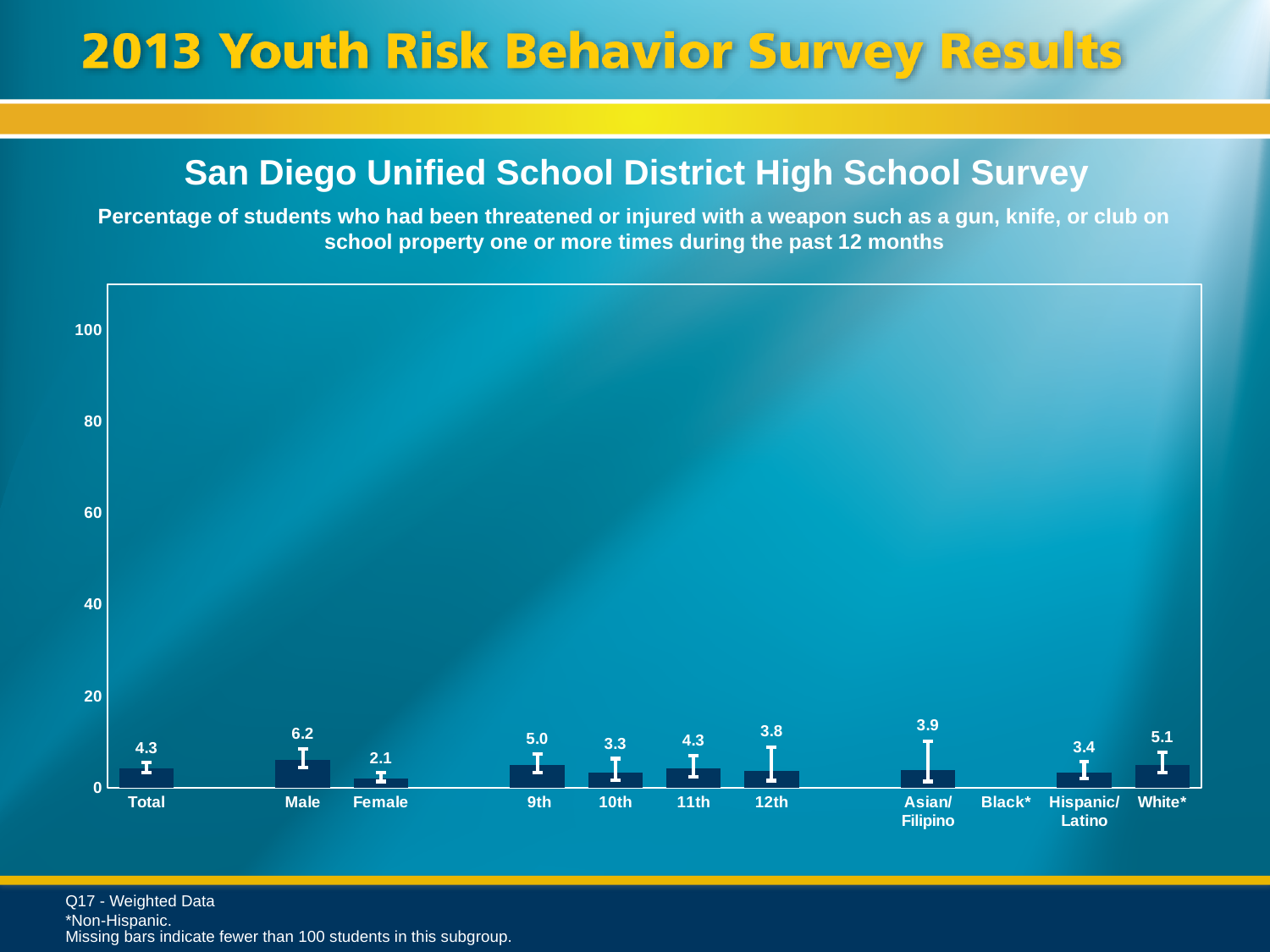
Which category has the highest value? Male Is the value for White* greater or less than 20? less Which category has no bar shown? Black* Which category has the lowest value among those with bars? Female What kind of chart is this? Bar chart What is the difference between the Male and Female values? 4.1 What is the value for Total? 4.3 Which is larger, the value for 10th grade or the value for 12th grade? 12th What is the value for 9th grade? 5.0 What is the value for Male? 6.2 What is the value for Hispanic/Latino? 3.4 What is the value for Female? 2.1